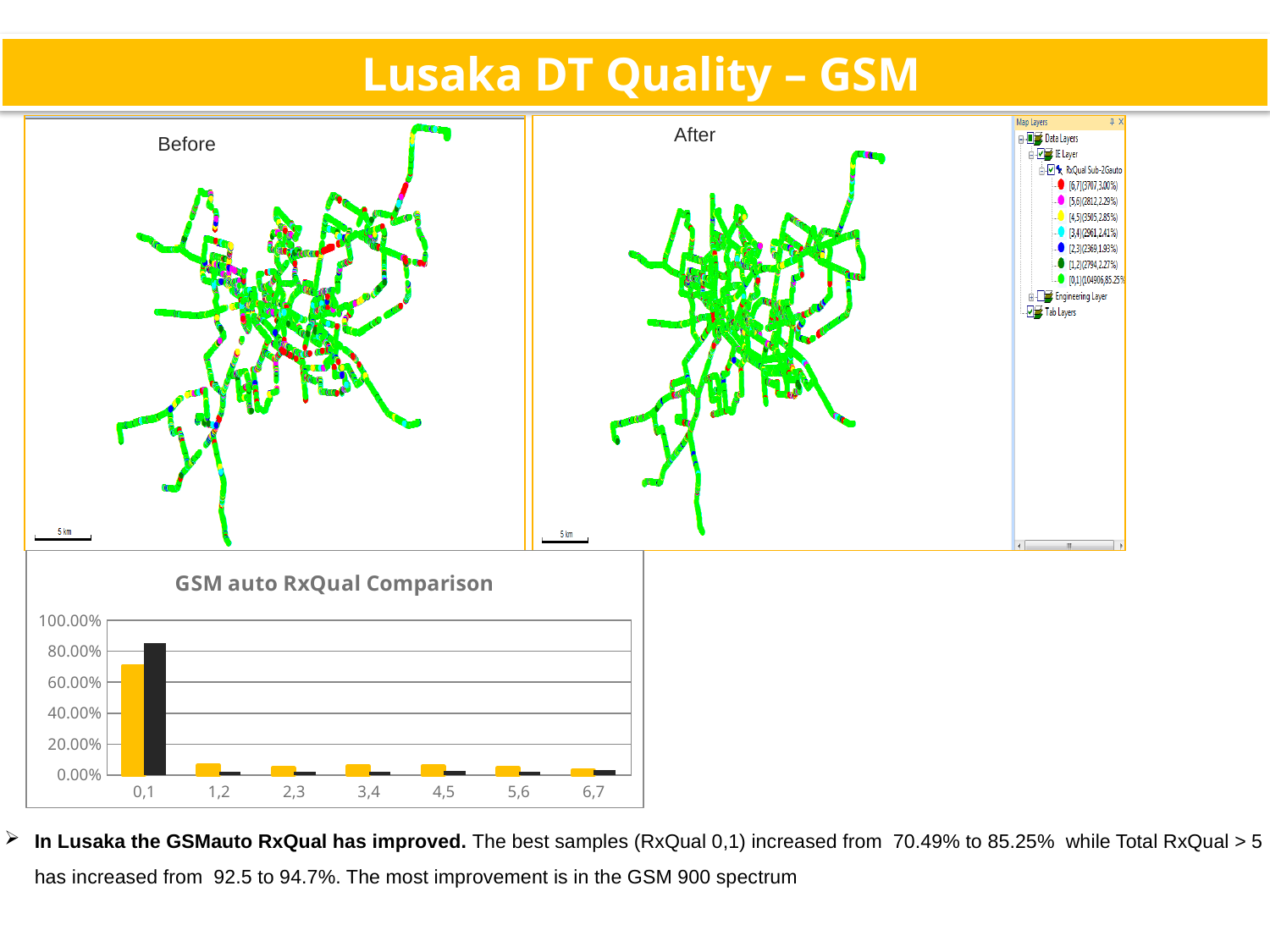
What kind of chart is the 'GSM auto RxQual Comparison' chart? bar chart What is the title of the bar chart on the slide? GSM auto RxQual Comparison What is the highest value shown on the y axis of the 'GSM auto RxQual Comparison' chart? 100.00% In the 'GSM auto RxQual Comparison' chart, is the black bar for category 6,7 greater or less than 20.00%? less In the 'GSM auto RxQual Comparison' chart, is the yellow bar for category 0,1 greater or less than 60.00%? greater In the 'GSM auto RxQual Comparison' chart, for category 0,1, which bar is taller, the yellow one or the black one? the black one In the 'GSM auto RxQual Comparison' chart, is the black bar for category 0,1 greater or less than 80.00%? greater In the 'GSM auto RxQual Comparison' chart, for category 1,2, which bar is taller, the yellow one or the black one? the yellow one How many categories are shown on the x axis of the 'GSM auto RxQual Comparison' chart? 7 In the 'GSM auto RxQual Comparison' chart, which category has the highest bars? 0,1